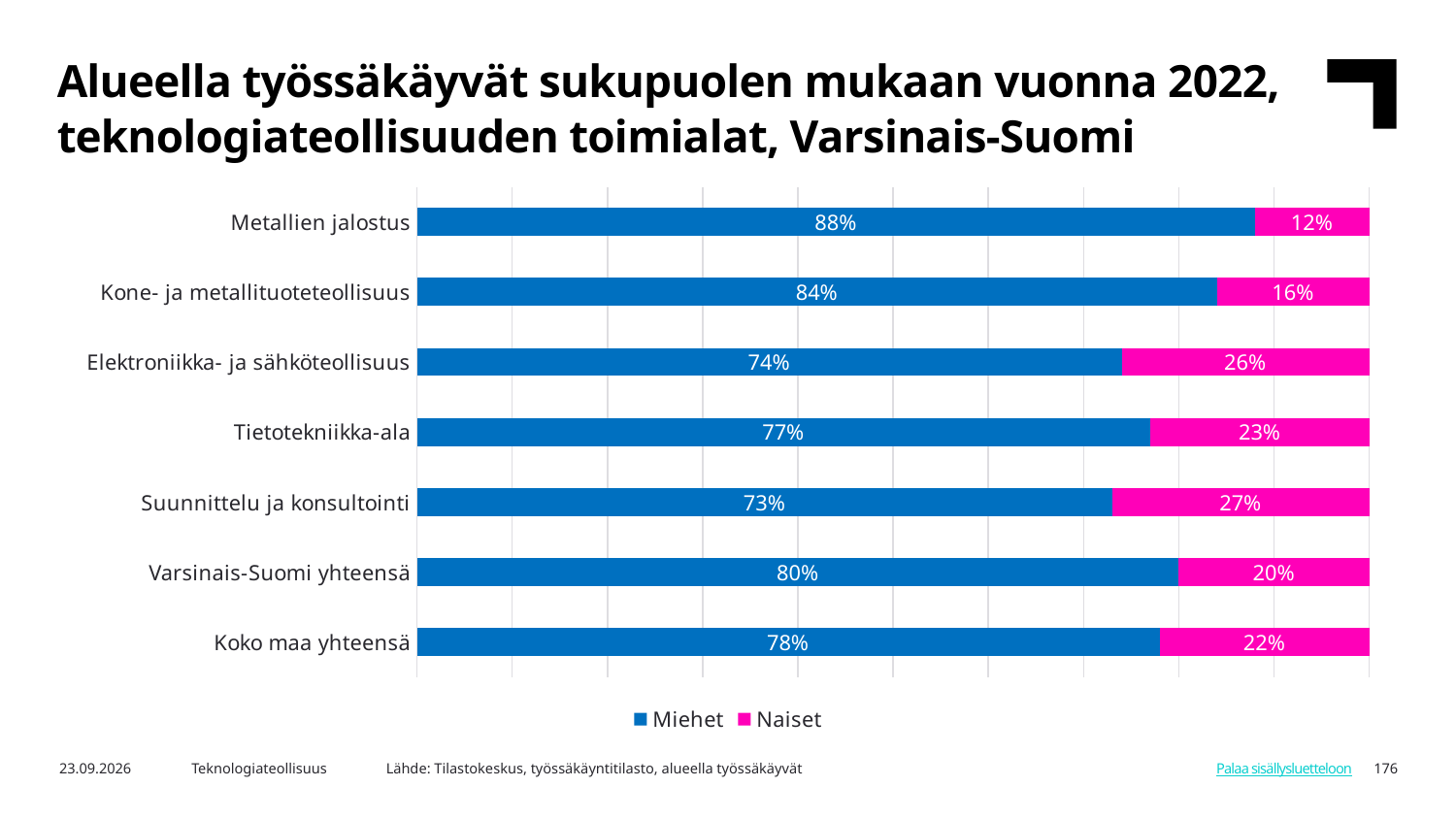
How many series does the legend list? 2 How many categories are shown on the chart? 7 Which is larger, the Naiset share for Elektroniikka- ja sähköteollisuus or for Koko maa yhteensä? Elektroniikka- ja sähköteollisuus What kind of chart is shown on the slide? Stacked bar chart What is the difference between the Miehet share for Kone- ja metallituoteteollisuus and for Tietotekniikka-ala? 7 percentage points What is the Naiset share for Suunnittelu ja konsultointi? 27% What is the Naiset share for Varsinais-Suomi yhteensä? 20% What is the Miehet share for Metallien jalostus? 88% What is the total of the stacked bar for Tietotekniikka-ala? 100% Which category has the lowest Naiset share? Metallien jalostus Which category has the highest Miehet share? Metallien jalostus Which category has the highest Naiset share? Suunnittelu ja konsultointi